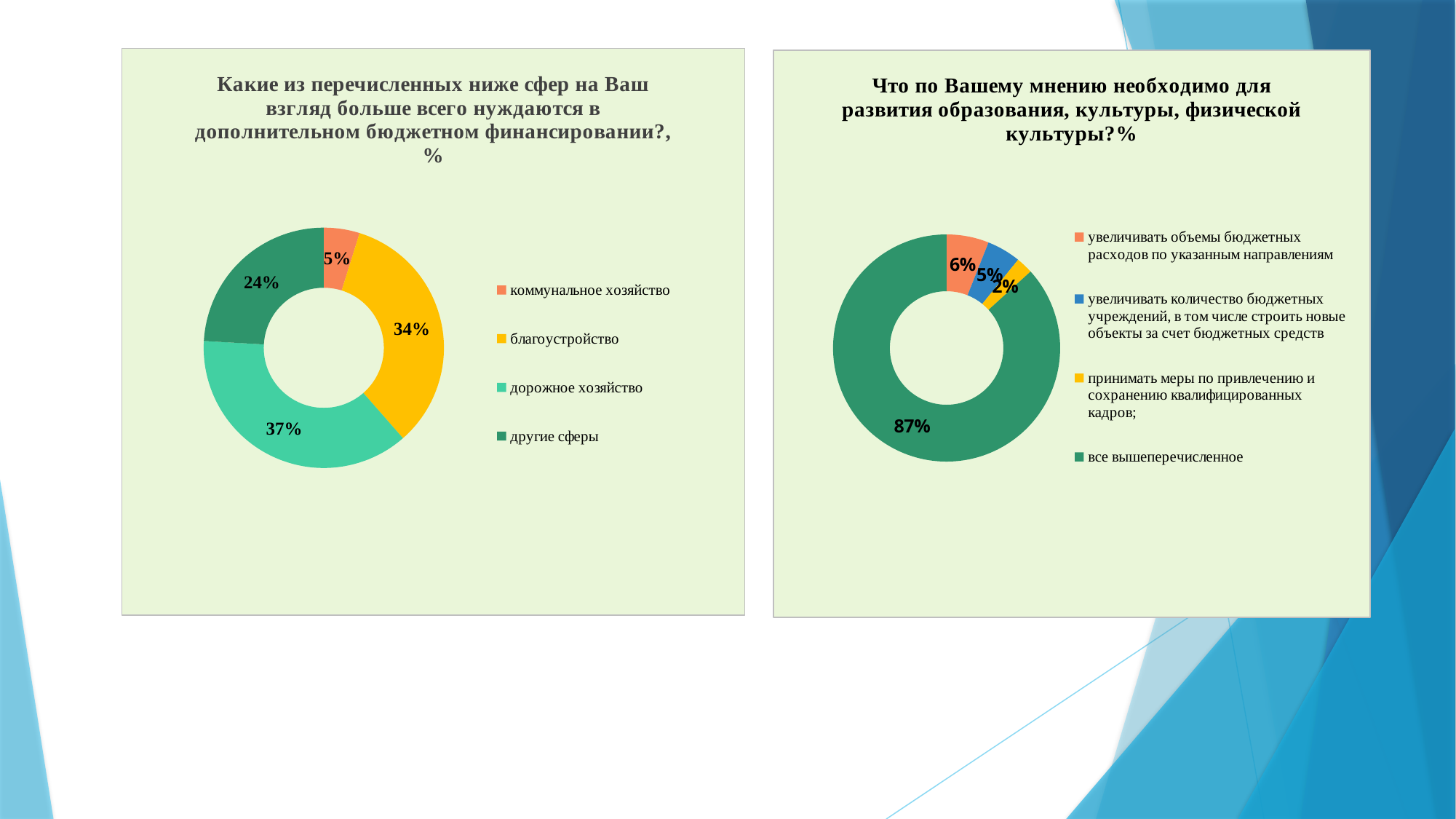
In the right chart, what percentage is shown for принимать меры по привлечению и сохранению квалифицированных кадров? 2% What type of chart is used on the right side of the slide? Doughnut chart In the right chart, which is larger: the share for увеличивать объемы бюджетных расходов по указанным направлениям or the share for увеличивать количество бюджетных учреждений? увеличивать объемы бюджетных расходов по указанным направлениям In the left chart, which category has the largest share? дорожное хозяйство In the left chart, which category has the smallest share? коммунальное хозяйство In the left chart, what percentage is shown for коммунальное хозяйство? 5% In the right chart, what percentage is shown for все вышеперечисленное? 87% In the left chart, how many categories does the legend list? 4 In the left chart, what percentage is shown for дорожное хозяйство? 37% In the right chart, what is the difference between the shares of все вышеперечисленное and увеличивать объемы бюджетных расходов по указанным направлениям? 81% In the left chart, what is the difference between the shares of дорожное хозяйство and благоустройство? 3% In the right chart, which category has the smallest share? принимать меры по привлечению и сохранению квалифицированных кадров